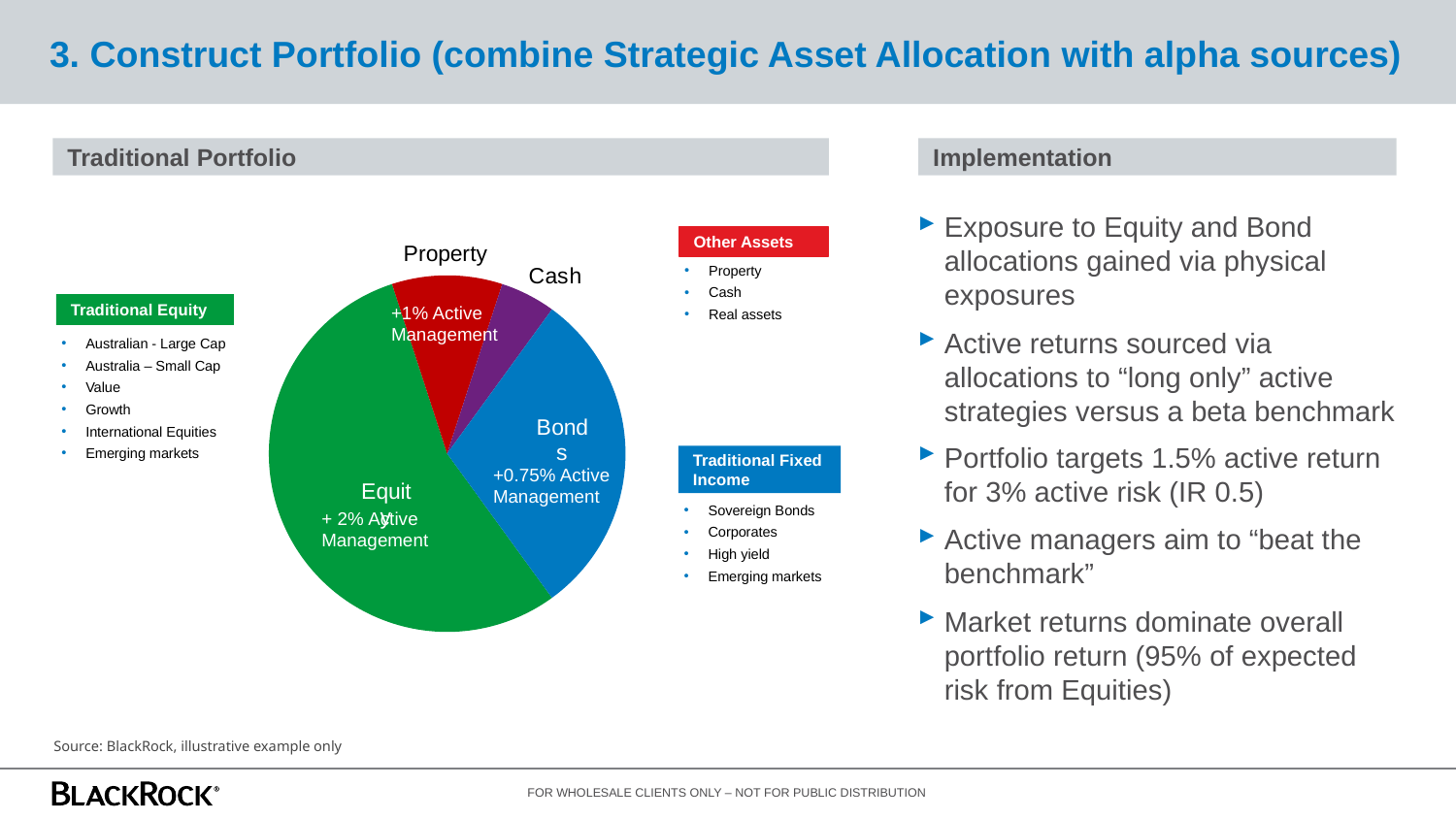
How many slices does the Traditional Portfolio pie chart have? 4 What active management figure is printed on the Equity slice of the pie chart? + 2% Which slice of the Traditional Portfolio pie chart is the smallest? Cash What colour is the Equity slice in the Traditional Portfolio pie chart? Green What kind of chart is shown under the Traditional Portfolio heading? Pie chart Which slice of the Traditional Portfolio pie chart is the largest? Equity What active management figure is printed on the Property slice of the pie chart? +1% Which slice of the Traditional Portfolio pie chart is coloured red? Property What active management figure is printed on the Bonds slice of the pie chart? +0.75% In the Traditional Portfolio pie chart, which slice is larger, Property or Cash? Property In the Traditional Portfolio pie chart, which slice is larger, Bonds or Property? Bonds In the Traditional Portfolio pie chart, which slice is larger, Equity or Bonds? Equity